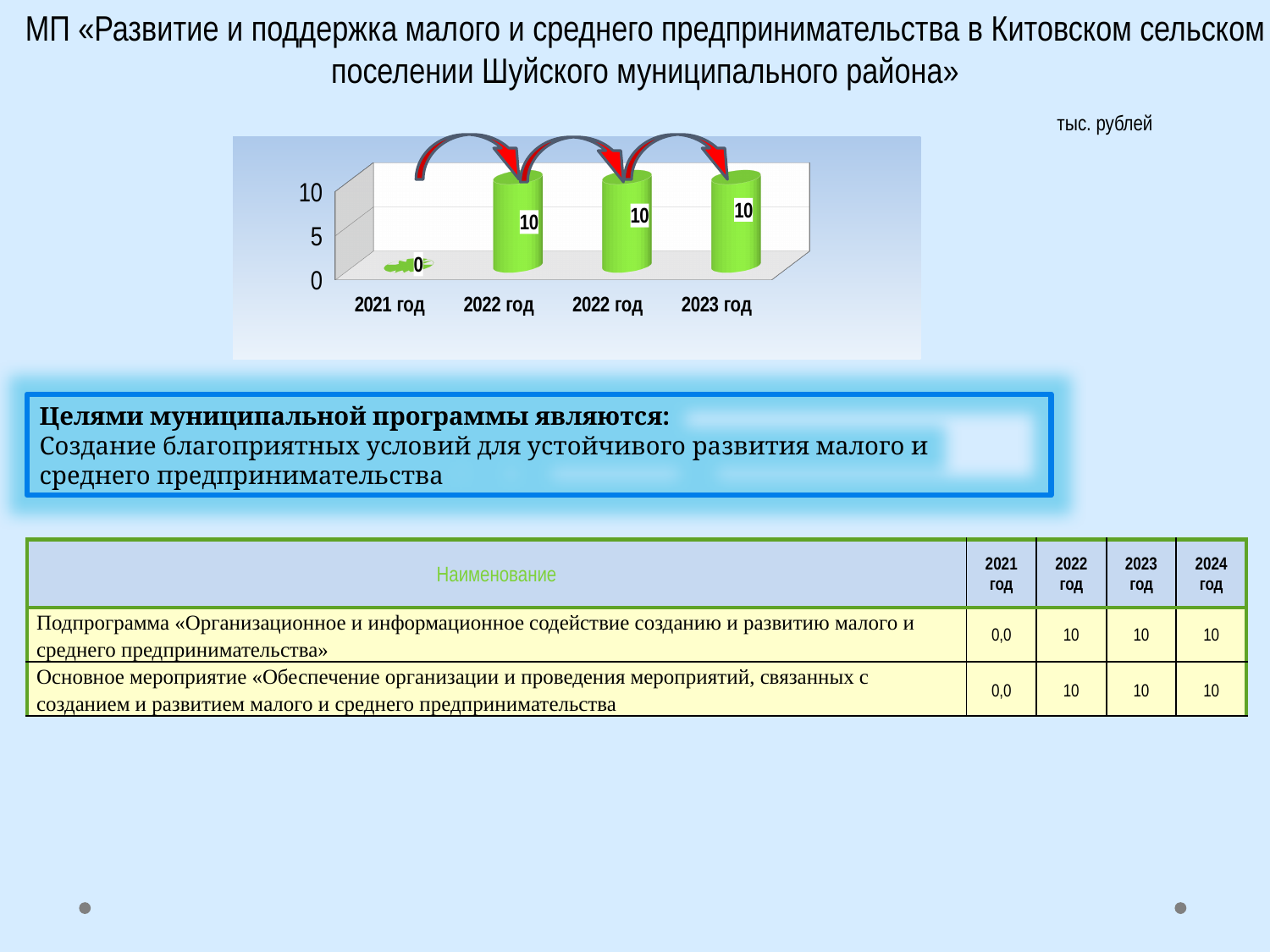
Which is larger, the value for 2021 год or the value for 2023 год? 2023 год Do the values rise or fall from 2021 год to 2022 год? rise How many categories are shown on the x axis of the chart? 4 What is the value for 2023 год? 10 How many of the chart's category labels read 2022 год? 2 What is the difference between the values for 2023 год and 2021 год? 10 Which category has the lowest value? 2021 год What unit is indicated next to the chart? тыс. рублей What is the highest tick value shown on the chart's vertical axis? 10 Is the value for 2023 год greater or less than 5? greater What kind of chart is shown on the slide? bar chart What is the value for 2021 год? 0